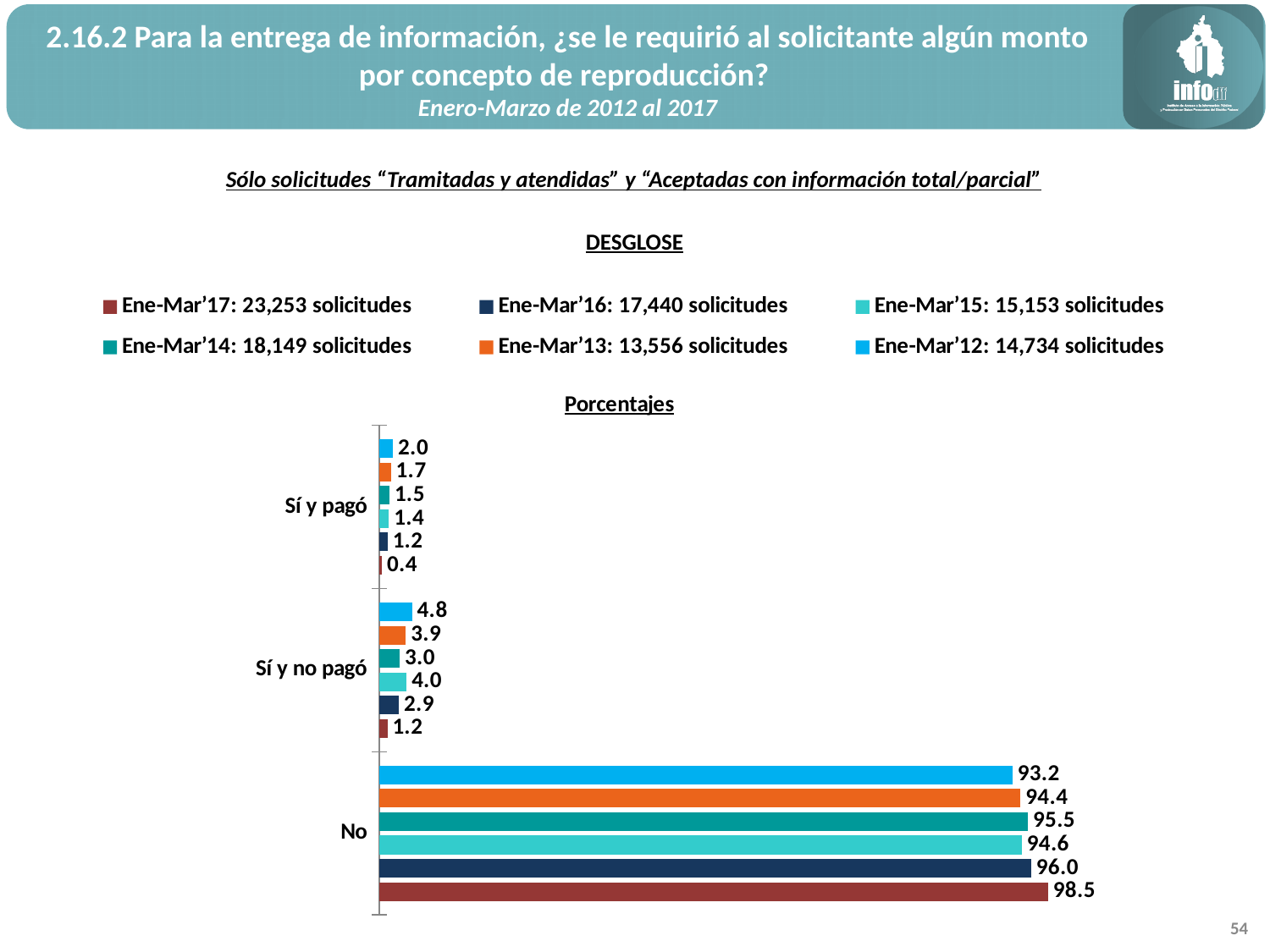
What is the difference between the Ene-Mar'17 and Ene-Mar'12 values in the "No" category? 5.3 Which series has the lowest value in the "No" category? Ene-Mar'12 How many series does the legend list? 6 How many categories are shown on the chart? 3 According to the legend, how many solicitudes does Ene-Mar'16 correspond to? 17,440 solicitudes What is the value for Ene-Mar'12 in the "Sí y no pagó" category? 4.8 Which series has the lowest value in the "Sí y pagó" category? Ene-Mar'17 What is the value for Ene-Mar'17 in the "No" category? 98.5 What is the value for Ene-Mar'15 in the "Sí y pagó" category? 1.4 What kind of chart is shown on the slide? Bar chart In the "Sí y no pagó" category, which is larger: the value for Ene-Mar'15 or for Ene-Mar'14? Ene-Mar'15 Which series has the highest value in the "No" category? Ene-Mar'17